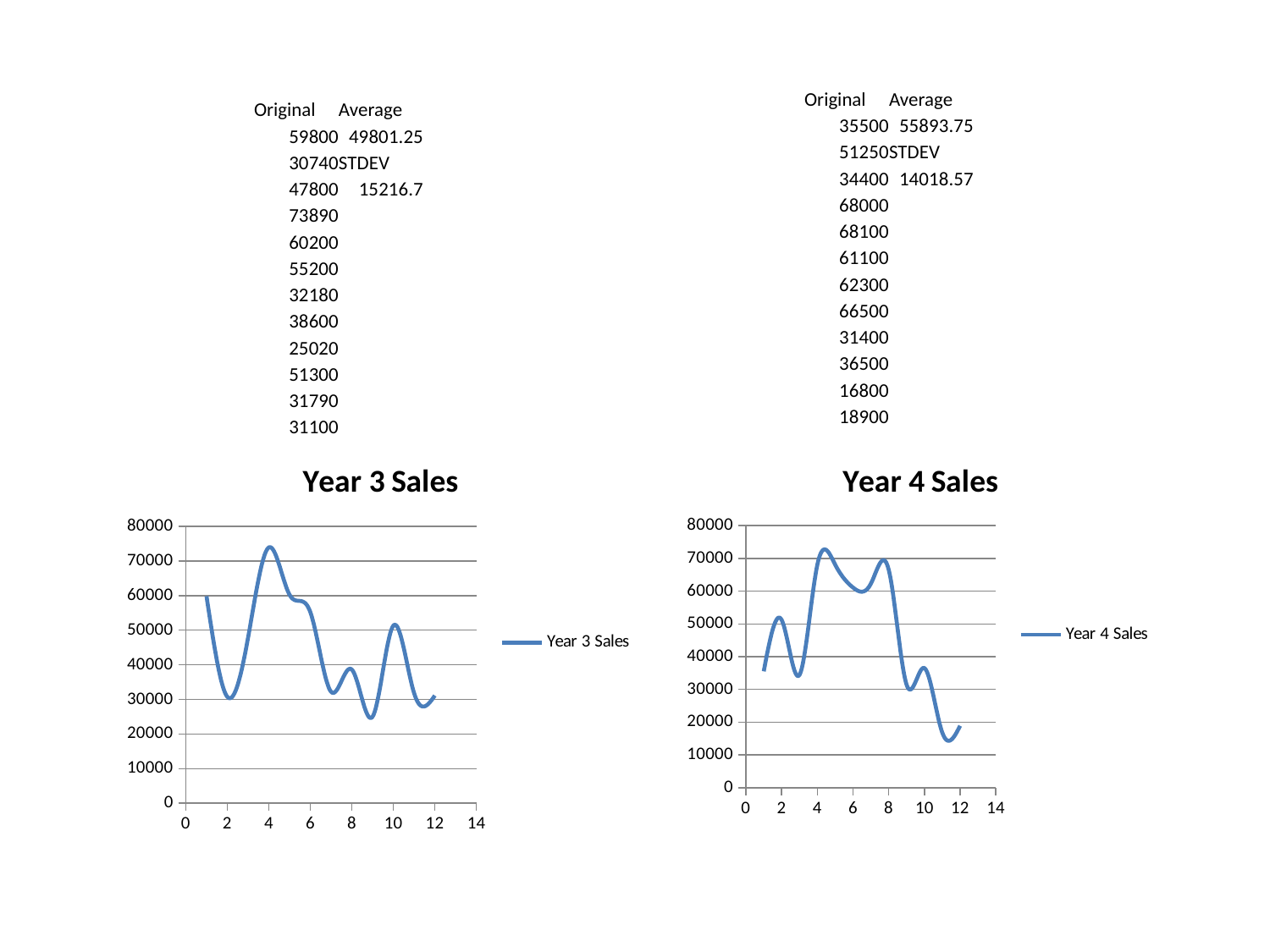
On the Year 4 Sales chart, do the values overall rise or fall from x = 8 to x = 11? fall On the Year 3 Sales chart, at which x value does the line reach its highest point? 4 On the Year 4 Sales chart, is the value at x = 8 greater or less than 60000? greater On the Year 4 Sales chart, is the value at x = 11 greater or less than 20000? less What kind of chart is the Year 3 Sales chart? line chart On the Year 4 Sales chart, which is larger, the value at x = 2 or the value at x = 3? x = 2 On the Year 3 Sales chart, at which x value does the line reach its lowest point? 9 How many series does the legend of the Year 4 Sales chart list? 1 How many data points are plotted on the Year 3 Sales chart? 12 What is the legend entry on the Year 3 Sales chart? Year 3 Sales On the Year 3 Sales chart, is the value at x = 9 greater or less than 30000? less